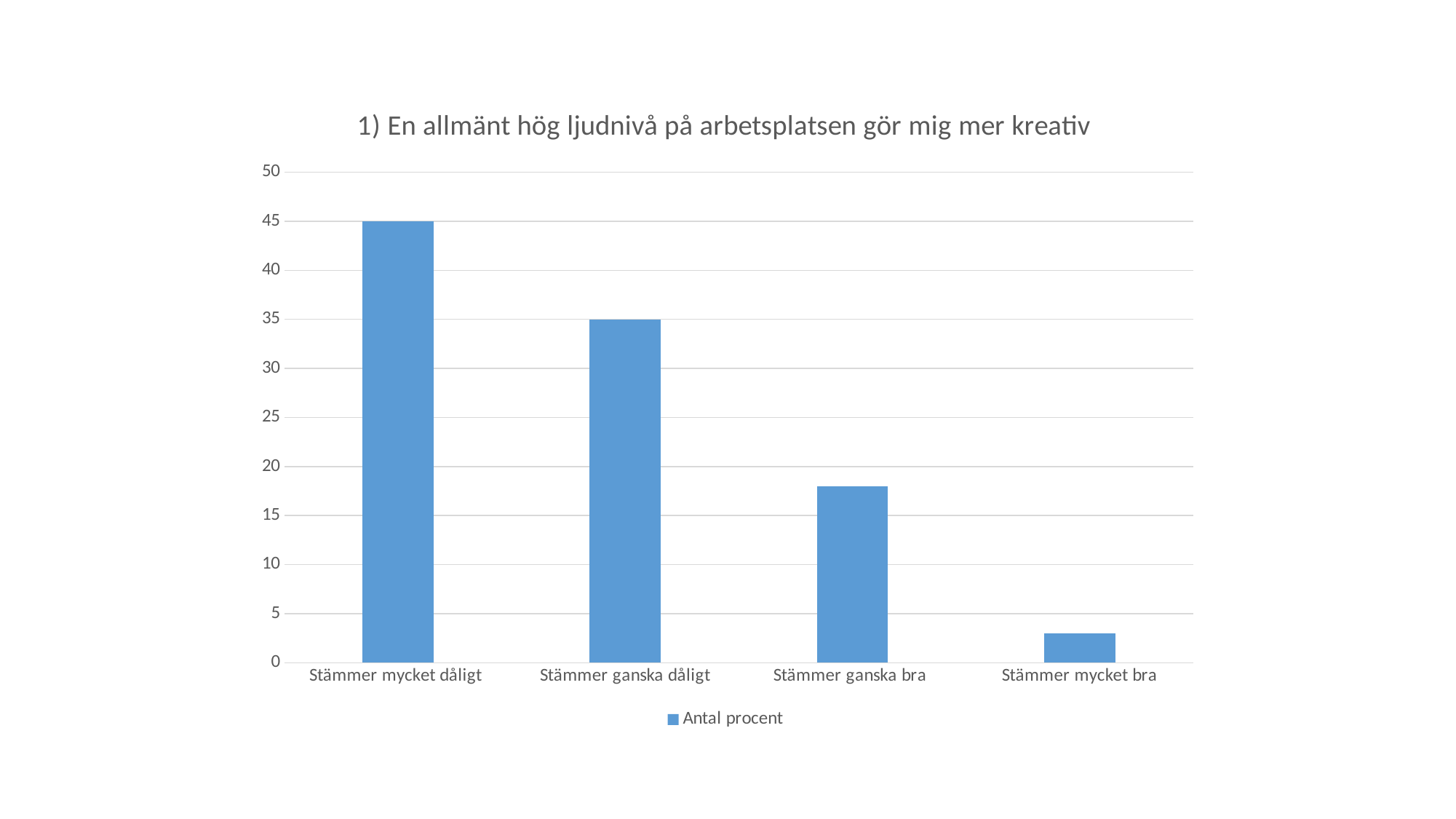
How many series does the legend list? 1 What is the difference between the values for Stämmer mycket dåligt and Stämmer ganska dåligt? 10 What is the value for Stämmer ganska dåligt? 35 Which category has the highest value? Stämmer mycket dåligt What is the value for Stämmer mycket dåligt? 45 Is the value for Stämmer mycket bra greater or less than 5? less Which is larger, the value for Stämmer ganska bra or the value for Stämmer mycket bra? Stämmer ganska bra What kind of chart is shown? bar chart Is the value for Stämmer ganska bra greater or less than 20? less Do the values rise or fall from left to right along the x axis? fall How many categories are shown on the x axis? 4 Which category has the lowest value? Stämmer mycket bra